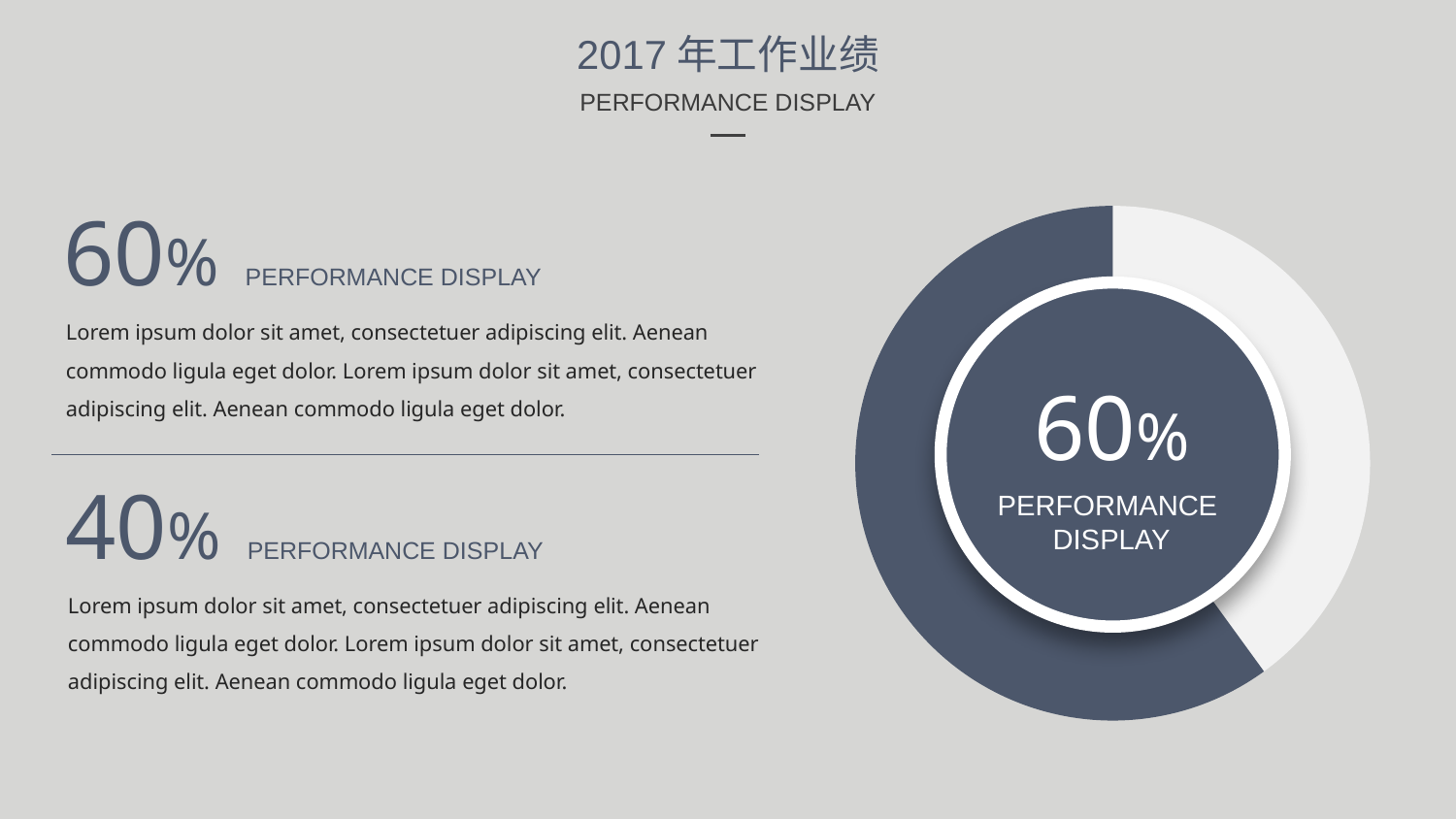
What is the difference between the two percentages shown on the left of the slide, 60% and 40%? 20% Is the dark blue-grey slice of the donut chart greater or less than 50% of the whole? greater Which slice of the donut chart is larger, the dark blue-grey one or the light grey one? The dark blue-grey one What share of the donut chart does the dark blue-grey slice represent? 60% What kind of chart is shown on the right side of the slide? Donut chart How many slices does the donut chart have? 2 What percentage is printed in the centre of the donut chart? 60% What share of the donut chart does the light grey slice represent? 40% What is the English subtitle shown under the slide title? PERFORMANCE DISPLAY What text appears below the percentage in the centre of the donut chart? PERFORMANCE DISPLAY